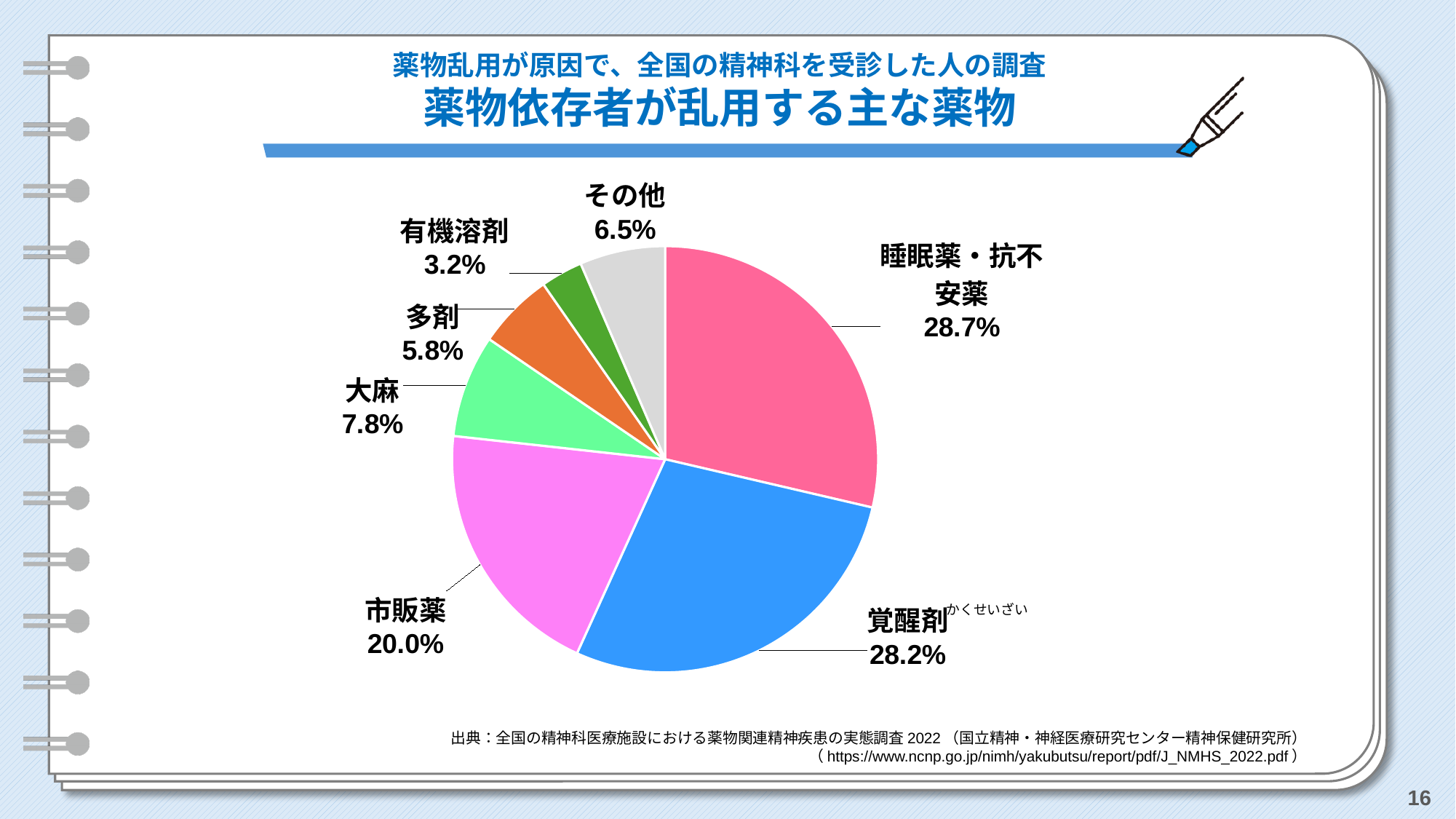
How many categories are shown in the pie chart? 7 What is the difference between the shares of 市販薬 and 大麻? 12.2% What type of chart is shown on the slide? pie chart Which is larger, the share for 多剤 or the share for その他? その他 What is the share for 覚醒剤? 28.2% Which category has the largest share? 睡眠薬・抗不安薬 What is the share for 大麻? 7.8% What is the share for 市販薬? 20.0% What is the title of the chart? 薬物依存者が乱用する主な薬物 What is the share for 睡眠薬・抗不安薬? 28.7% What is the share for 有機溶剤? 3.2% Which category has the smallest share? 有機溶剤